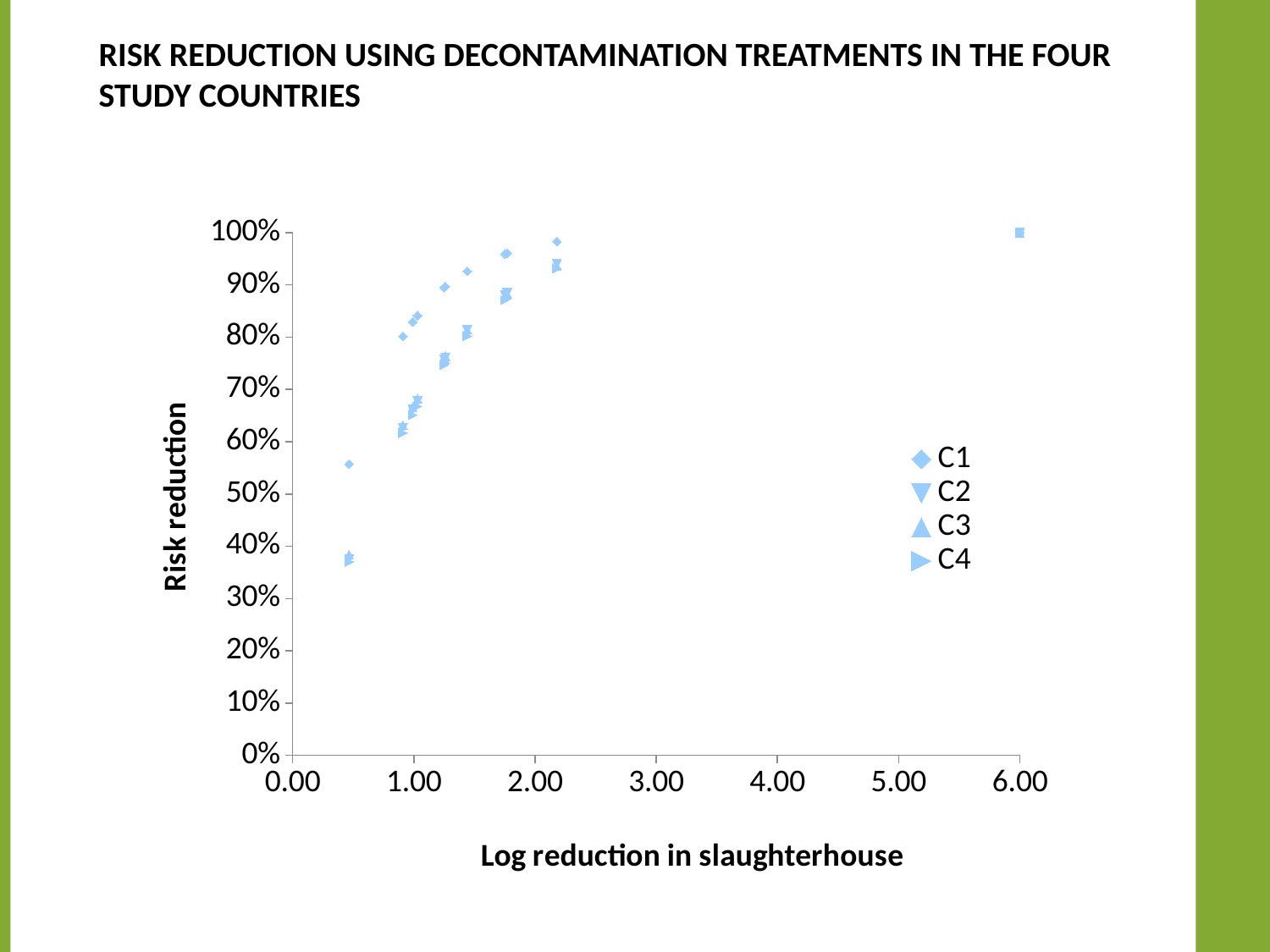
Is the risk reduction of the highest C1 point greater or less than 90%? greater Is the risk reduction of the lowest plotted point greater or less than 40%? less Is the risk reduction of the leftmost C1 point greater or less than 50%? greater What is the maximum value shown on the y axis? 100% Does risk reduction rise or fall as log reduction in slaughterhouse increases? rise How many series does the legend list? 4 What is the risk reduction for the point at a log reduction of 6.00? 100% What are the series names listed in the legend? C1, C2, C3, C4 What is the label of the x axis? Log reduction in slaughterhouse What kind of chart is shown on the slide? scatter chart